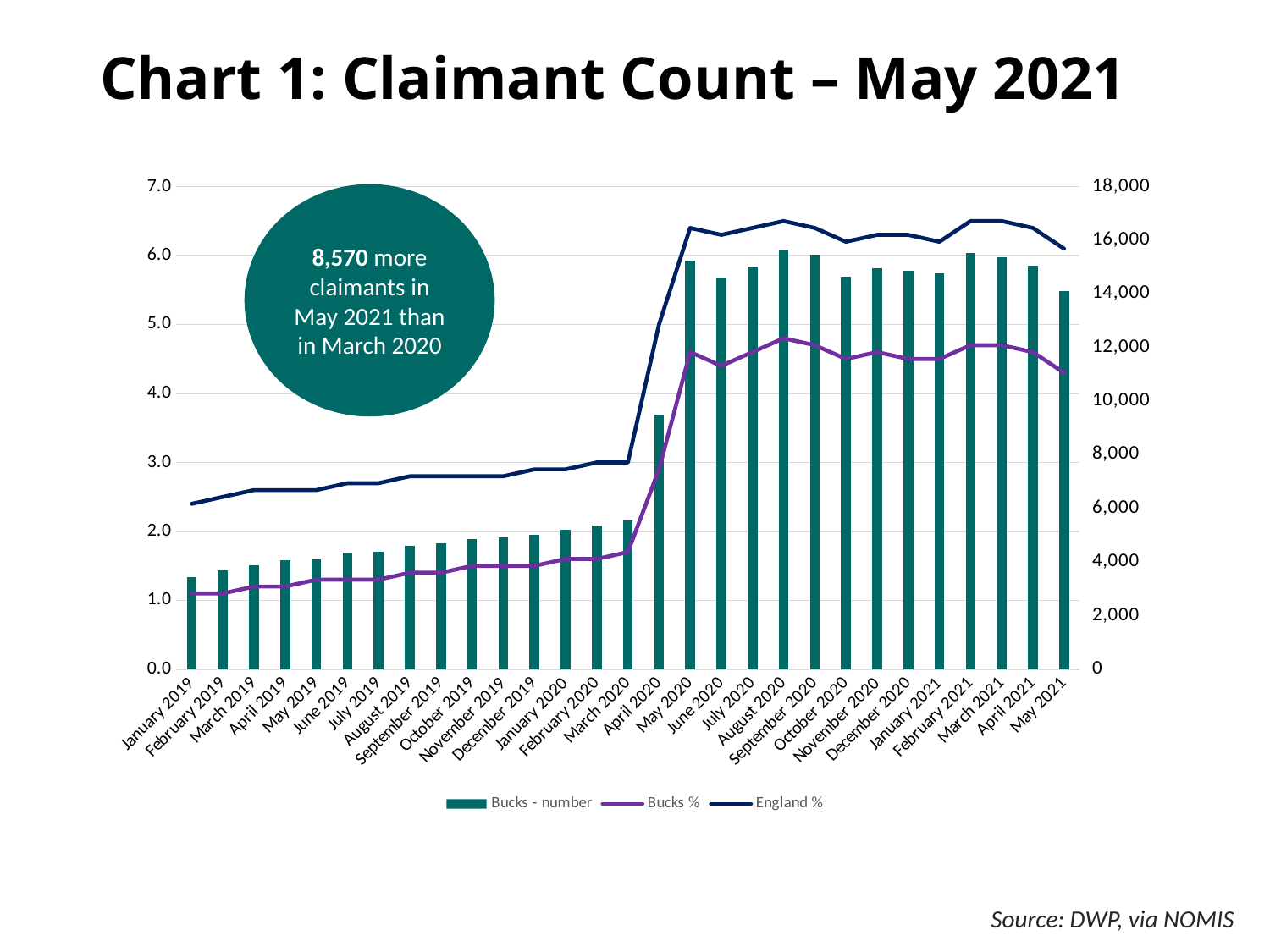
Do the Bucks - number bars rise or fall from January 2019 to March 2020? rise Is the Bucks % value for January 2019 greater or less than 2.0? less What kind of chart is shown? Combined bar and line chart According to the callout on the chart, how many more claimants were there in May 2021 than in March 2020? 8,570 What are the three series named in the legend? Bucks - number, Bucks %, England % How many months are plotted along the x axis? 29 Which is larger, the Bucks - number bar for April 2020 or for May 2020? May 2020 Is the Bucks - number value for January 2019 greater or less than 4,000? less Which month has the lowest Bucks - number bar? January 2019 How many series does the legend list? 3 Is the England % value for May 2020 greater or less than 6.0? greater